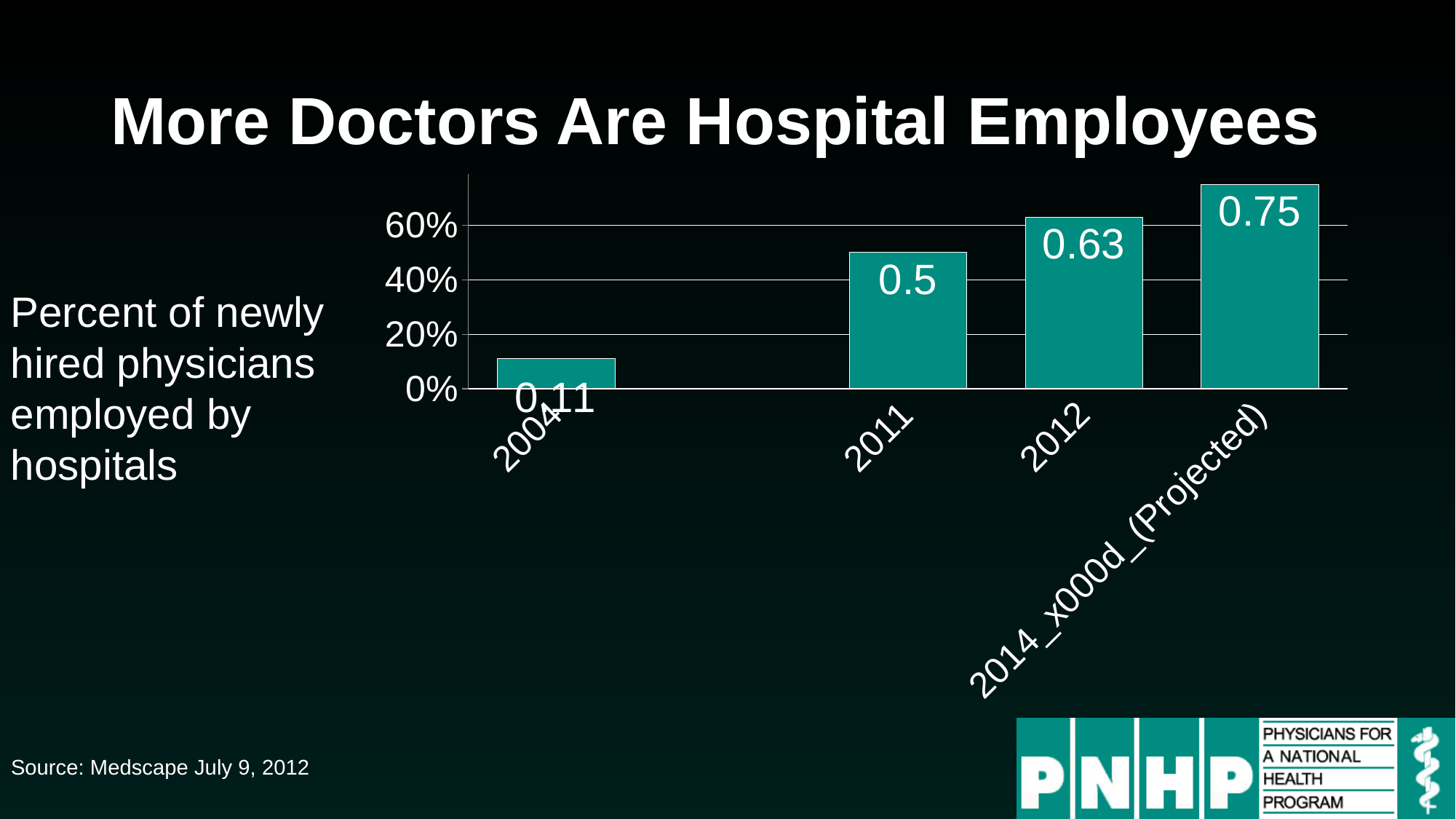
What is the difference between the data labels for 2012 and 2011? 0.13 What type of chart is shown on the slide? bar chart What is the data label on the bar for 2011? 0.5 Which year has the lowest bar? 2004 Which year has the highest bar? 2014 (Projected) What is the data label on the bar for 2014 (Projected)? 0.75 Do the values rise or fall from 2004 to 2014 (Projected)? rise How many bars are plotted in the chart? 4 What is the data label on the bar for 2012? 0.63 What is the data label on the bar for 2004? 0.11 Which is larger, the value for 2011 or the value for 2012? 2012 Is the value for 2004 greater or less than 20%? less